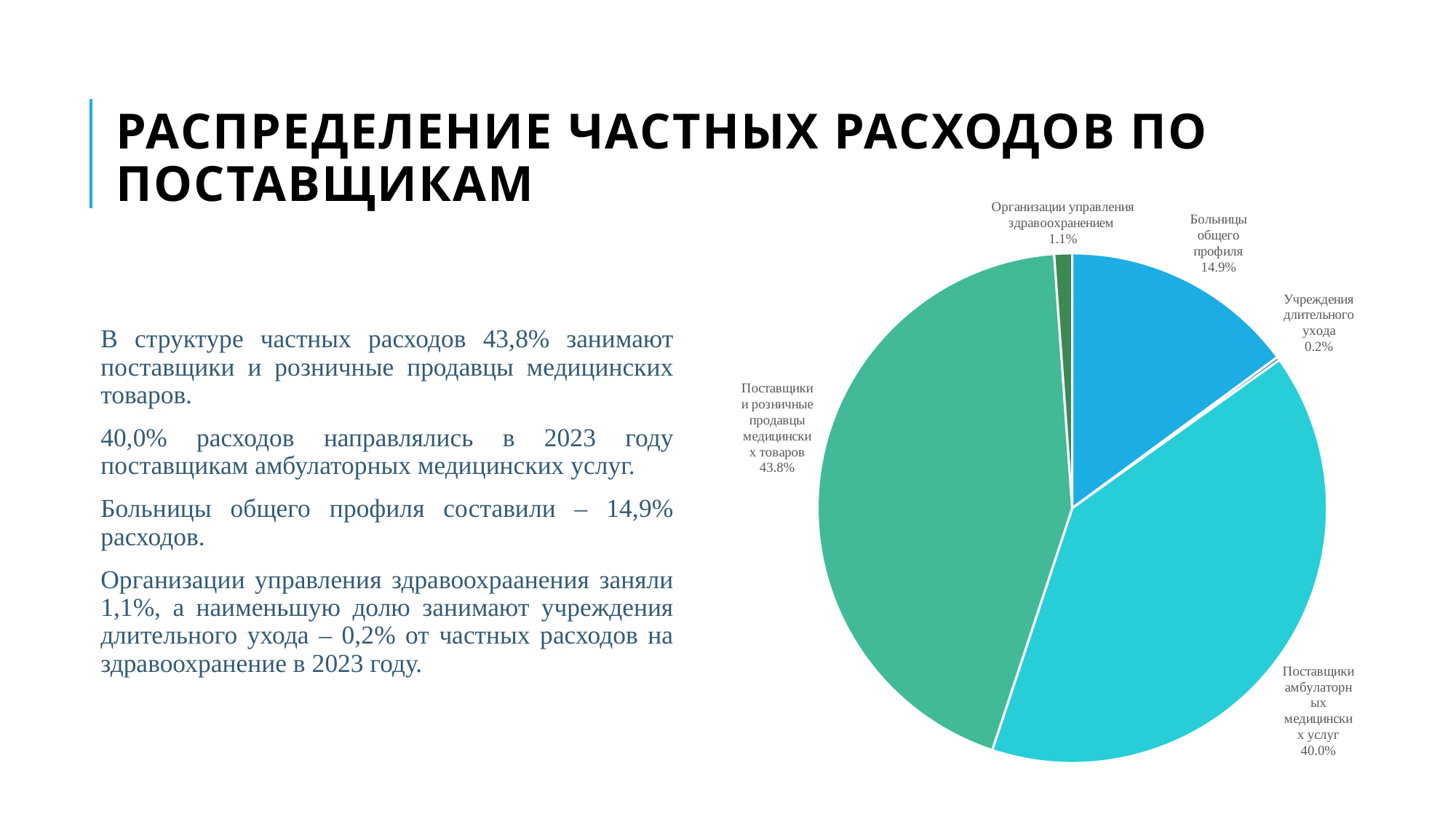
На сколько процентных пунктов доля поставщиков и розничных продавцов медицинских товаров больше доли поставщиков амбулаторных медицинских услуг? 3.8 Какая категория имеет наименьшую долю на диаграмме? Учреждения длительного ухода Какую долю занимают поставщики и розничные продавцы медицинских товаров на диаграмме? 43.8% Какой тип диаграммы показан на слайде? Круговая диаграмма Какая категория имеет наибольшую долю на диаграмме? Поставщики и розничные продавцы медицинских товаров Какую долю занимают организации управления здравоохранением? 1.1% Как называется слайд с диаграммой? Распределение частных расходов по поставщикам Какую долю составляют больницы общего профиля? 14.9% Какую долю занимают учреждения длительного ухода? 0.2% Какую долю занимают поставщики амбулаторных медицинских услуг? 40.0% Сколько категорий (секторов) показано на круговой диаграмме? 5 Что больше: доля больниц общего профиля или доля организаций управления здравоохранением? Больницы общего профиля